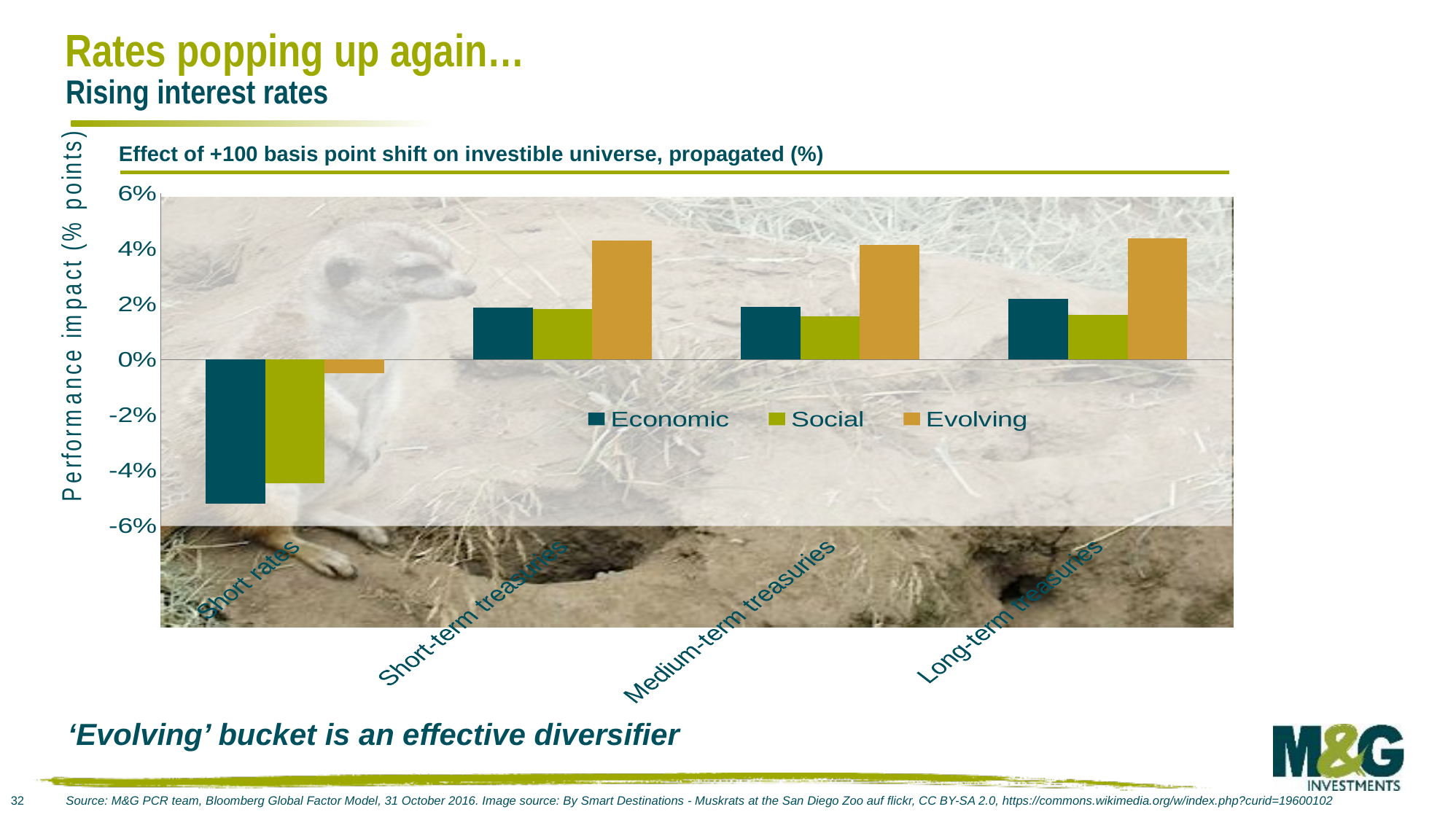
What kind of chart is shown on the slide? bar chart What are the three series listed in the chart's legend? Economic, Social, Evolving How many series does the chart's legend list? 3 Is the Social value for Medium-term treasuries greater or less than 2%? less Which series has the highest value for Long-term treasuries? Evolving Is the Evolving value for Short rates greater or less than -2%? greater What is the title of the chart? Effect of +100 basis point shift on investible universe, propagated (%) How many categories are shown along the x axis of the chart? 4 Is the Evolving value for Short-term treasuries greater or less than 4%? greater Which series has the lowest value for Short rates? Economic For Short rates, which is larger: the Social value or the Evolving value? Evolving